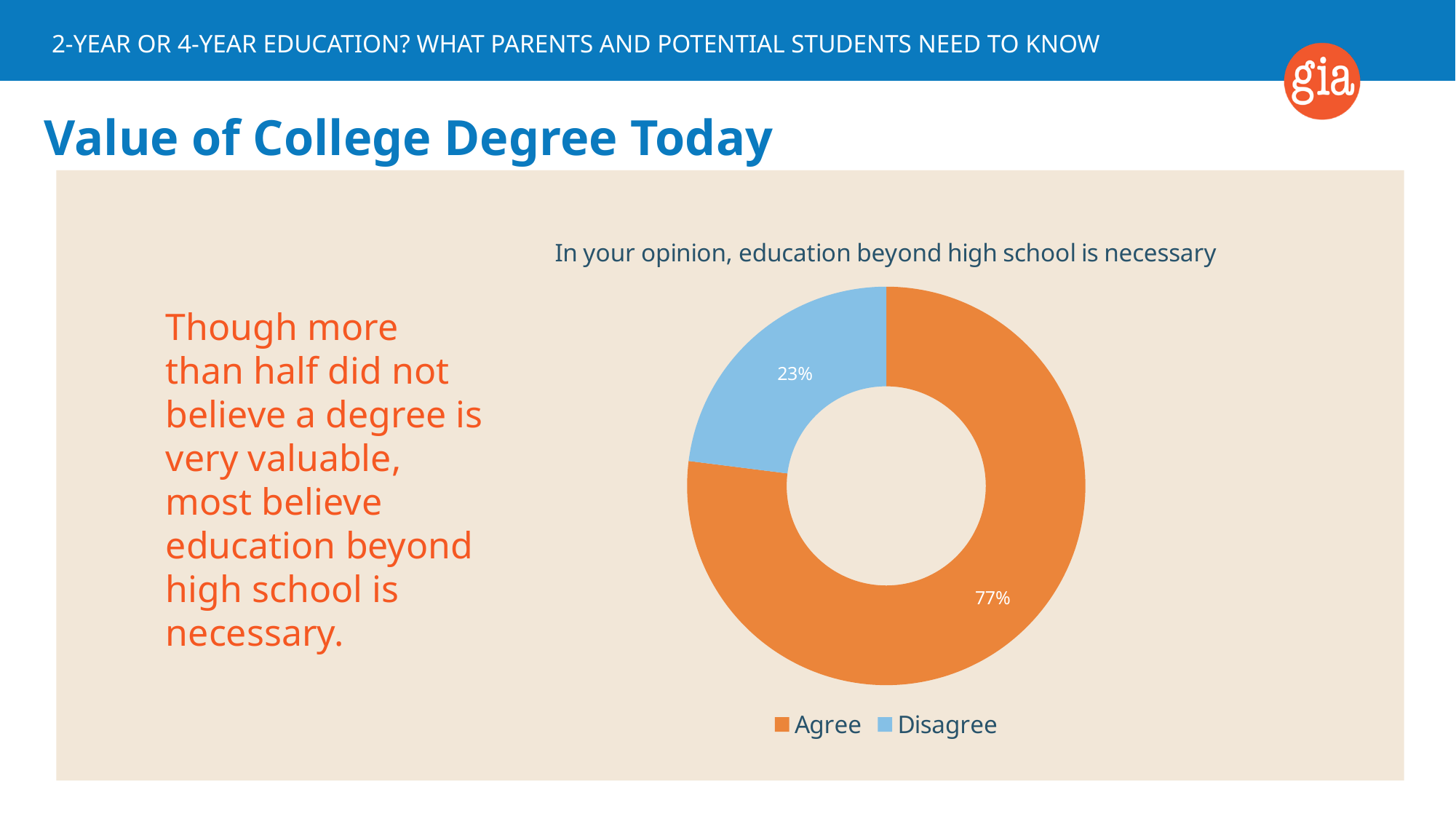
What is the difference in percentage points between Agree and Disagree? 54 What percentage of respondents agree that education beyond high school is necessary? 77% What kind of chart is shown on the slide? Doughnut (pie) chart What is the title of the chart? In your opinion, education beyond high school is necessary What colour represents the Disagree category in the chart? Light blue How many entries does the chart legend list? 2 What percentage of respondents disagree that education beyond high school is necessary? 23% Which response has the smallest share of the chart? Disagree How many categories are shown in the chart? 2 What share of the chart does the Agree slice represent? 77% Which is larger, the share for Agree or the share for Disagree? Agree Which response has the largest share of the chart? Agree